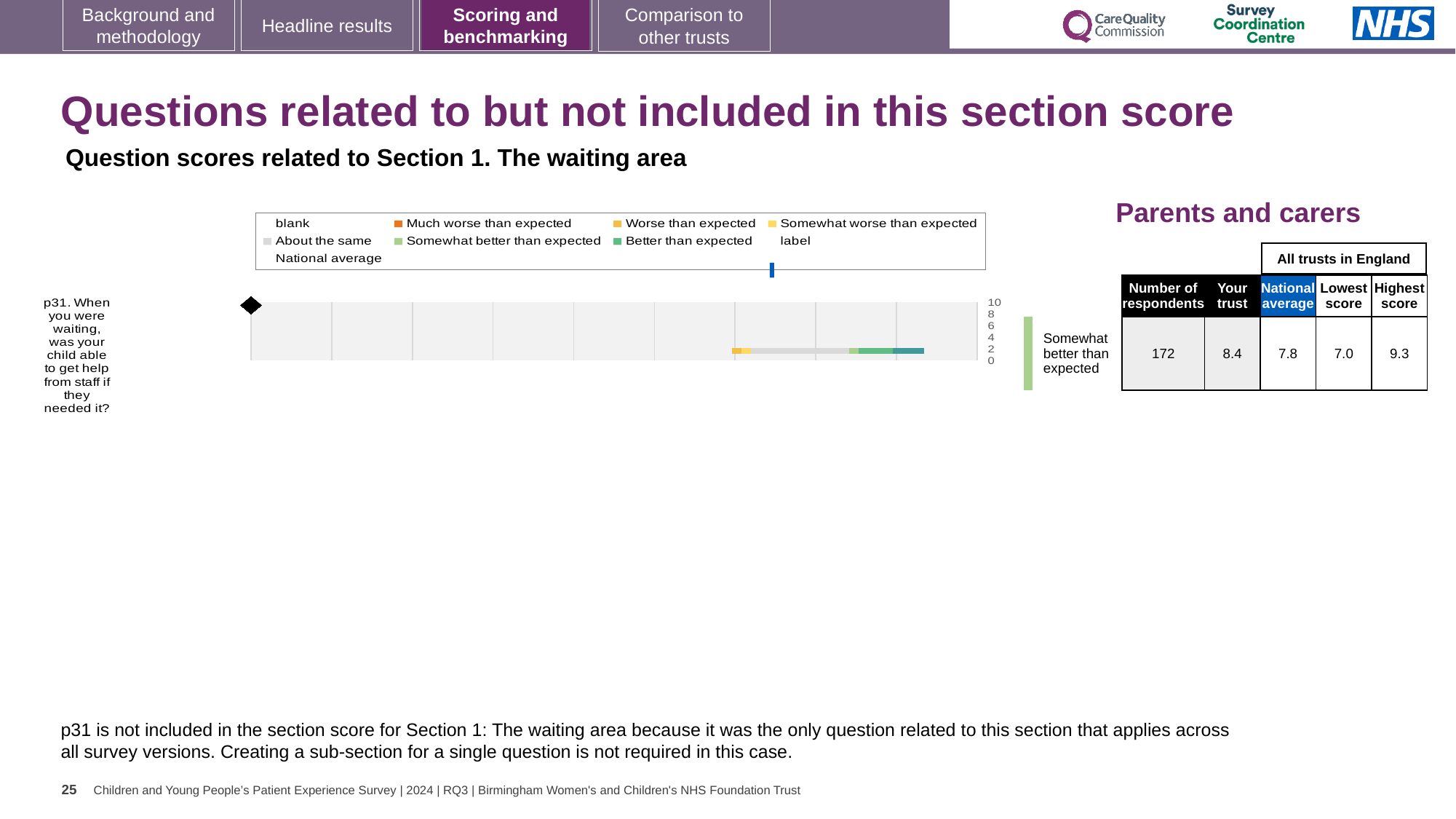
What is the difference between the 'Your trust' score and the national average for p31? 0.6 What is the maximum value shown on the chart's score axis? 10 Which is larger for p31: the 'Your trust' score or the national average? Your trust How many questions (categories) are plotted in the chart? 1 What is the national average score for p31? 7.8 How many respondents answered p31? 172 What is the lowest score among all trusts in England for p31? 7.0 What kind of chart is used to show the p31 question score? bar chart What is the 'Your trust' score for p31? 8.4 What rating label is shown next to the chart for p31? Somewhat better than expected What is the highest score among all trusts in England for p31? 9.3 Which question is plotted in the chart? p31. When you were waiting, was your child able to get help from staff if they needed it?